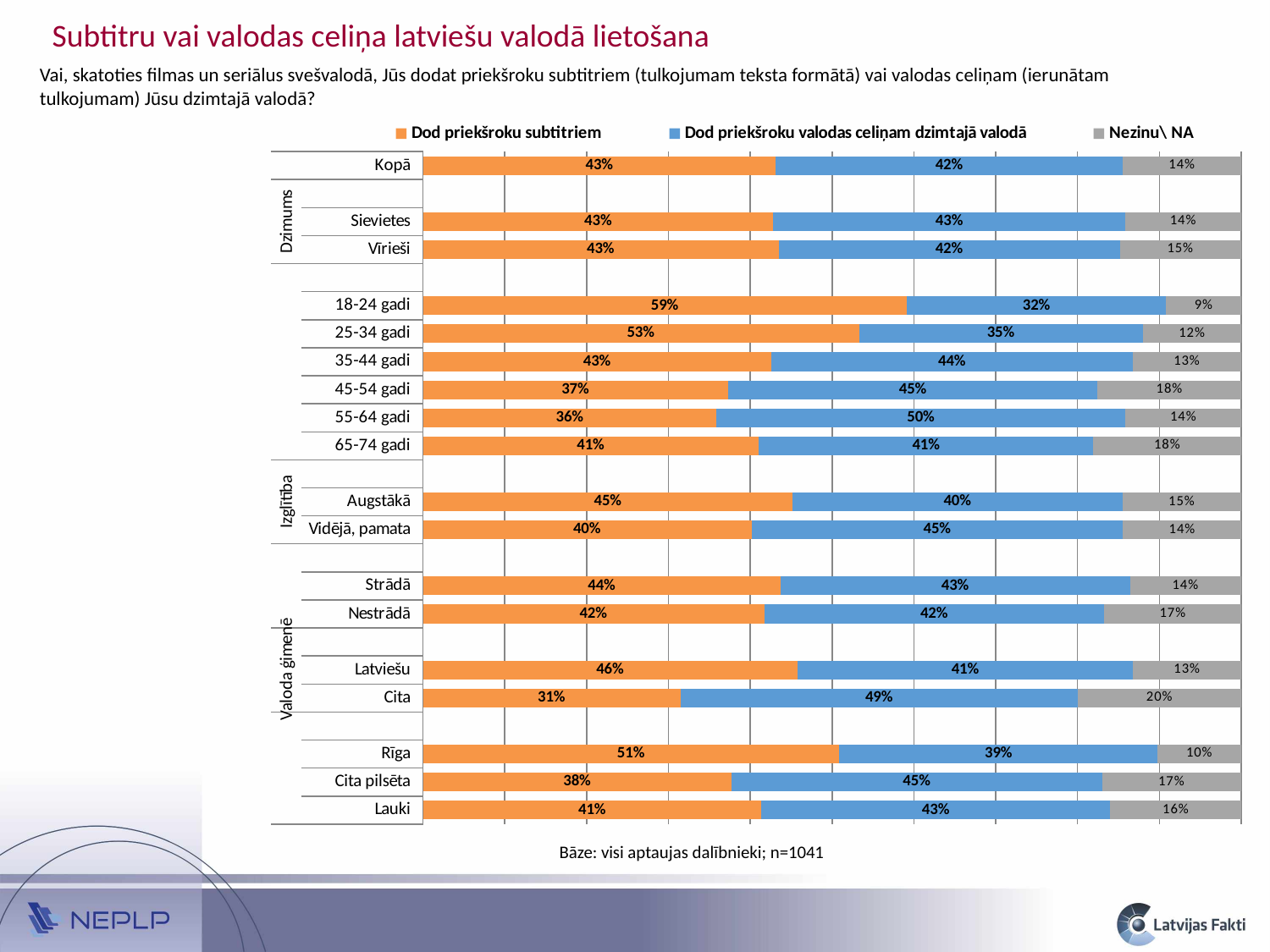
How many series does the legend list? 3 What percentage of the 18-24 gadi group prefers subtitles (Dod priekšroku subtitriem)? 59% What kind of chart is shown on the slide? Stacked bar chart Which category has the lowest 'Nezinu\ NA' share? 18-24 gadi What is the 'Nezinu\ NA' share for the Cita category? 20% Which category has the highest share for 'Dod priekšroku subtitriem'? 18-24 gadi What is the difference between the subtitle preference of Rīga and Cita pilsēta? 13 percentage points What is the value of 'Dod priekšroku valodas celiņam dzimtajā valodā' for the 55-64 gadi group? 50% Which is larger for the 45-54 gadi group: the share preferring subtitles or the share preferring the language track in the native language? Dod priekšroku valodas celiņam dzimtajā valodā Which category has the lowest share for 'Dod priekšroku subtitriem'? Cita How many categories (bars) are plotted in the chart? 18 What is the total of the three segments for the Kopā bar? 99%